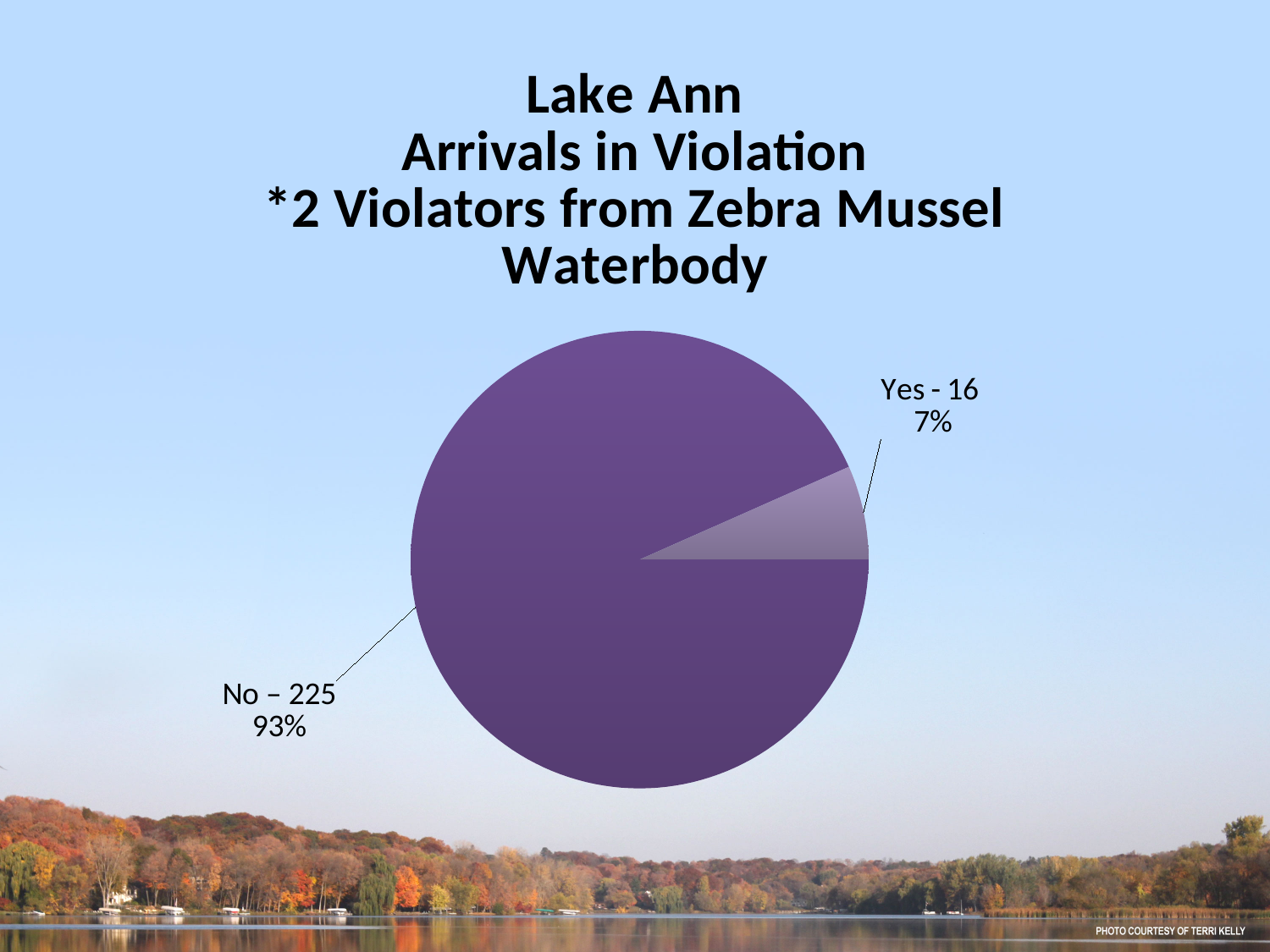
How many arrivals were not in violation (No) at Lake Ann? 225 Which slice of the pie is the smallest? Yes How many arrivals were in violation (Yes) at Lake Ann? 16 Which is larger, the Yes count or the No count? No What is the total number of arrivals shown in the pie chart? 241 According to the title, how many violators came from a Zebra Mussel waterbody? 2 How many slices does the pie chart have? 2 What type of chart is shown on the slide? pie chart Which slice of the pie is the largest? No What is the difference between the number of No arrivals and Yes arrivals? 209 What percentage of arrivals were in violation (Yes)? 7% What percentage of arrivals were not in violation (No)? 93%